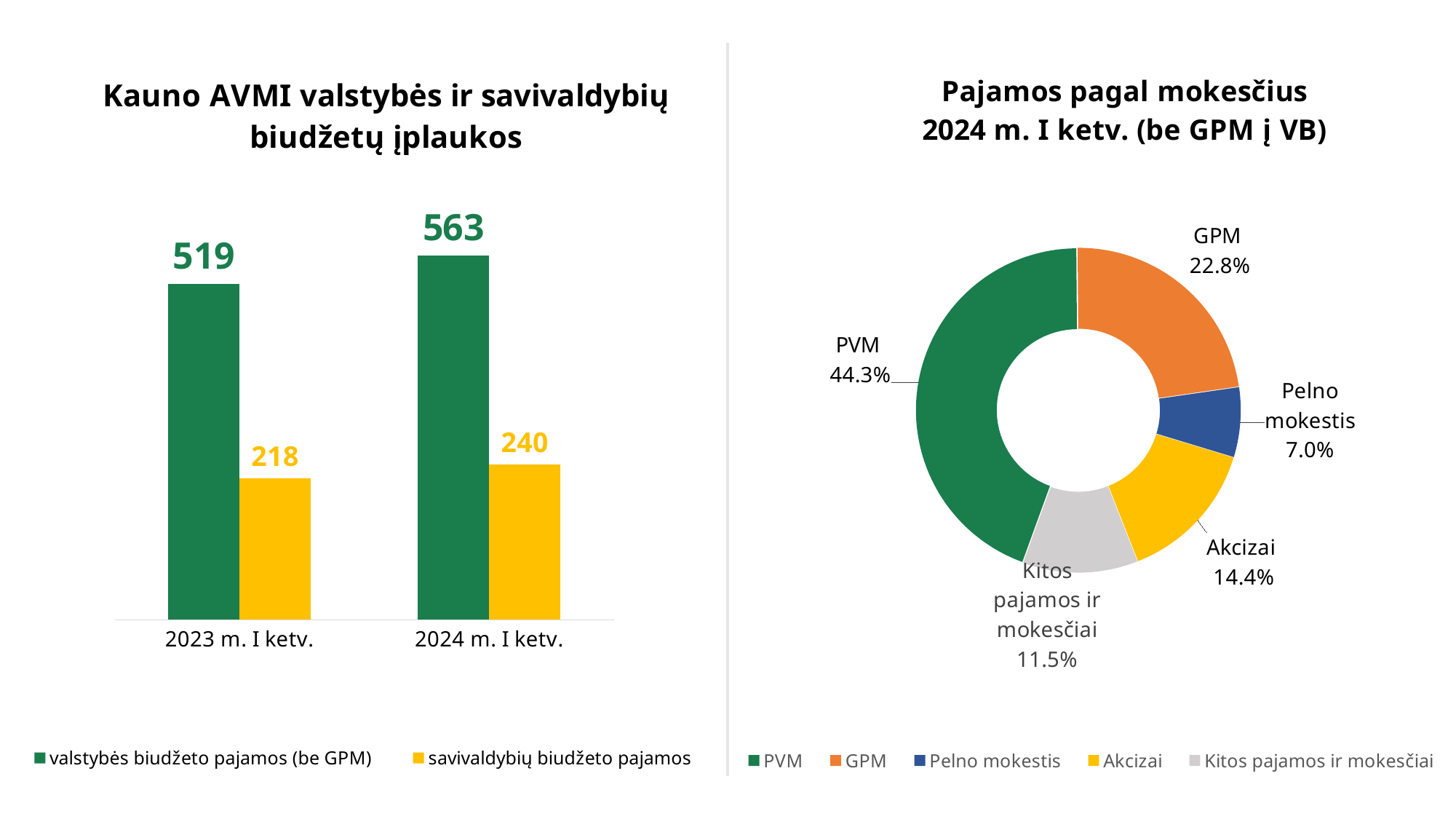
In the left chart 'Kauno AVMI valstybės ir savivaldybių biudžetų įplaukos', what is the value of 'savivaldybių biudžeto pajamos' for 2023 m. I ketv.? 218 In the left chart 'Kauno AVMI valstybės ir savivaldybių biudžetų įplaukos', what is the value of 'valstybės biudžeto pajamos (be GPM)' for 2024 m. I ketv.? 563 What kind of chart is the left chart 'Kauno AVMI valstybės ir savivaldybių biudžetų įplaukos'? bar chart In the right chart 'Pajamos pagal mokesčius 2024 m. I ketv. (be GPM į VB)', what share does 'Pelno mokestis' have? 7.0% In the right chart 'Pajamos pagal mokesčius 2024 m. I ketv. (be GPM į VB)', which is larger, Akcizai or 'Kitos pajamos ir mokesčiai'? Akcizai In the right chart 'Pajamos pagal mokesčius 2024 m. I ketv. (be GPM į VB)', which category has the smallest share? Pelno mokestis In the left chart 'Kauno AVMI valstybės ir savivaldybių biudžetų įplaukos', what is the difference between 'valstybės biudžeto pajamos (be GPM)' in 2024 m. I ketv. and 2023 m. I ketv.? 44 In the left chart 'Kauno AVMI valstybės ir savivaldybių biudžetų įplaukos', does 'savivaldybių biudžeto pajamos' rise or fall from 2023 m. I ketv. to 2024 m. I ketv.? rise In the right chart 'Pajamos pagal mokesčius 2024 m. I ketv. (be GPM į VB)', how many categories are shown? 5 In the left chart 'Kauno AVMI valstybės ir savivaldybių biudžetų įplaukos', what is the difference between 'savivaldybių biudžeto pajamos' in 2024 m. I ketv. and 2023 m. I ketv.? 22 In the left chart 'Kauno AVMI valstybės ir savivaldybių biudžetų įplaukos', how many series does the legend list? 2 In the right chart 'Pajamos pagal mokesčius 2024 m. I ketv. (be GPM į VB)', what share does PVM have? 44.3%